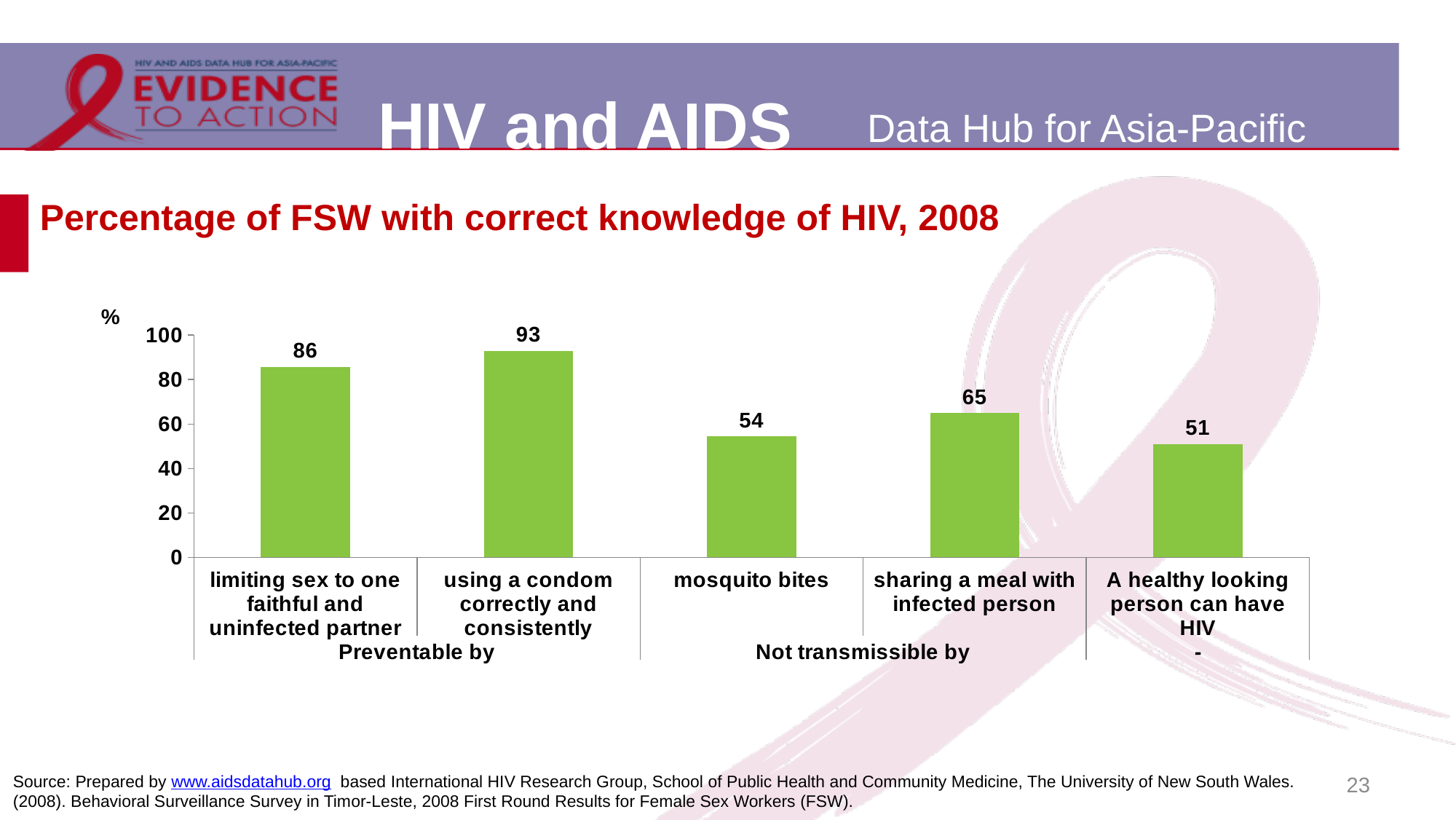
What percentage of FSW had correct knowledge that HIV is not transmissible by mosquito bites? 54 How many categories are shown in the chart? 5 What is the value for 'A healthy looking person can have HIV'? 51 Which category has the lowest percentage? A healthy looking person can have HIV What is the difference between the values for 'sharing a meal with infected person' and 'mosquito bites'? 11 Which category has the highest percentage? using a condom correctly and consistently What type of chart is shown on the slide? bar chart What is the title of the chart? Percentage of FSW with correct knowledge of HIV, 2008 Which is larger: the value for 'limiting sex to one faithful and uninfected partner' or the value for 'sharing a meal with infected person'? limiting sex to one faithful and uninfected partner What is the value for 'sharing a meal with infected person'? 65 What percentage of FSW had correct knowledge that HIV is preventable by using a condom correctly and consistently? 93 What is the difference between the values for 'using a condom correctly and consistently' and 'limiting sex to one faithful and uninfected partner'? 7